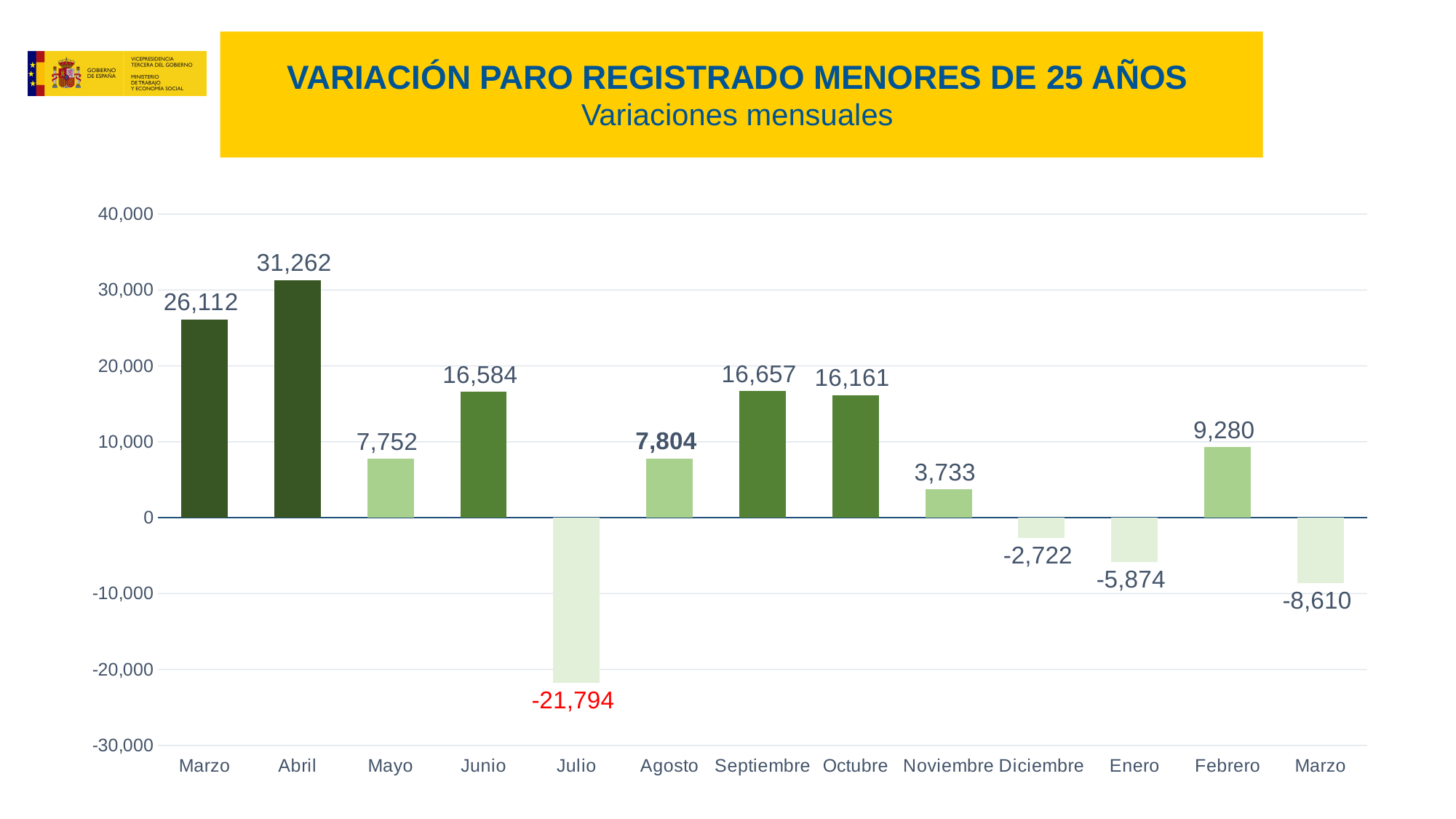
Which month has the highest value? Abril What is the value for Abril? 31,262 What is the value for Noviembre? 3,733 How many bars are plotted in the chart? 13 What kind of chart is shown on the slide? Bar chart Which is larger, the value for Septiembre or the value for Octubre? Septiembre What is the value for the last Marzo bar on the right of the chart? -8,610 Which month has the lowest value? Julio What is the value for Julio? -21,794 What is the difference between the values for Febrero and Enero? 15,154 What is the difference between the values for Abril and the first Marzo bar? 5,150 What is the title of the chart? VARIACIÓN PARO REGISTRADO MENORES DE 25 AÑOS